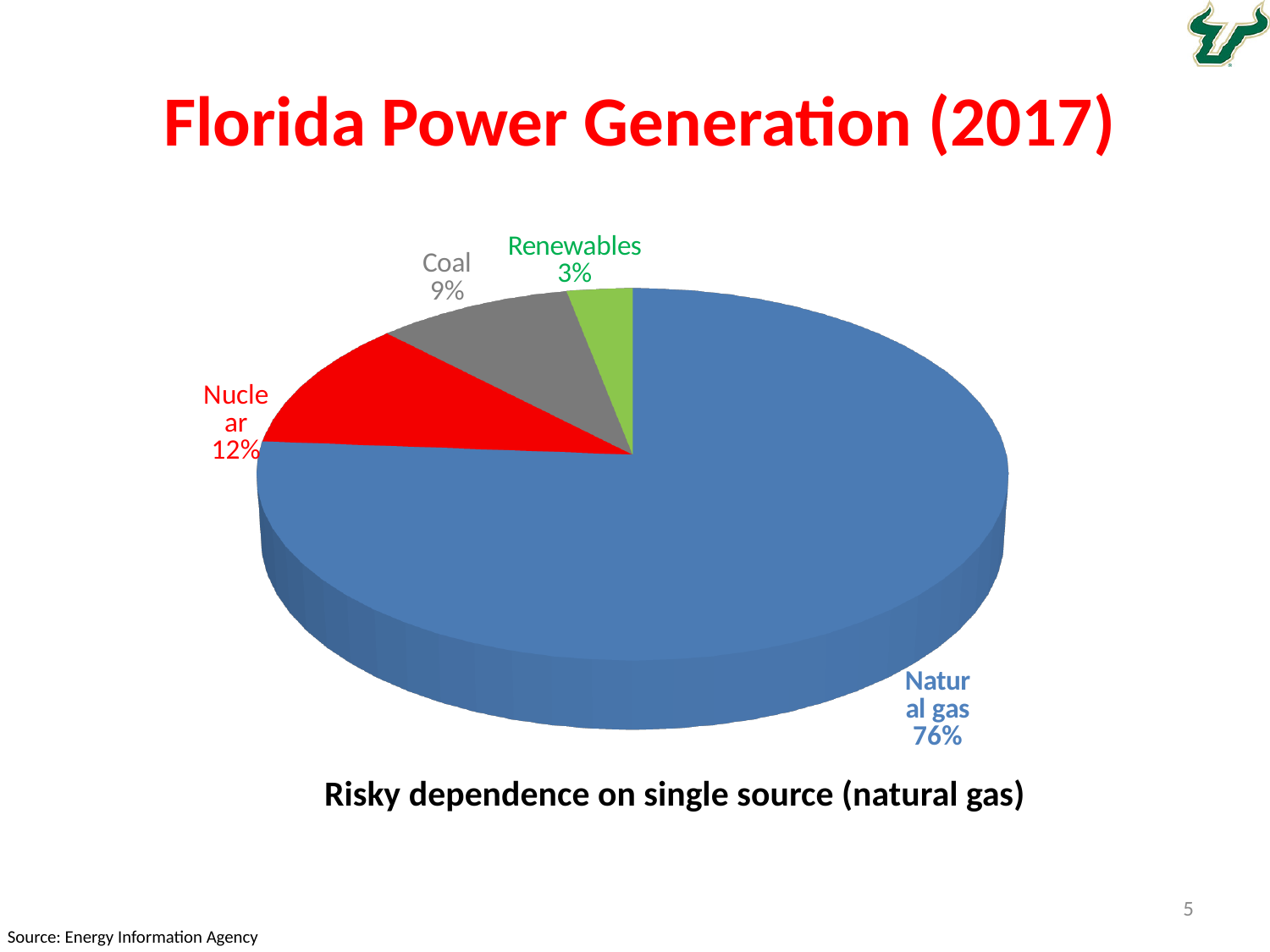
What colour is the Natural gas slice? Blue How many slices does the pie chart have? 4 What is the difference in percentage points between Natural gas and Nuclear? 64 Which source has the largest share of Florida power generation? Natural gas What share of Florida power generation in 2017 comes from natural gas? 76% What percentage of the pie is Coal? 9% Which is larger, the Coal share or the Renewables share? Coal What type of chart is shown on the slide? Pie chart What is the difference in percentage points between Nuclear and Coal? 3 What percentage of the pie is Nuclear? 12% What percentage of the pie is Renewables? 3% Which source has the smallest share of Florida power generation? Renewables